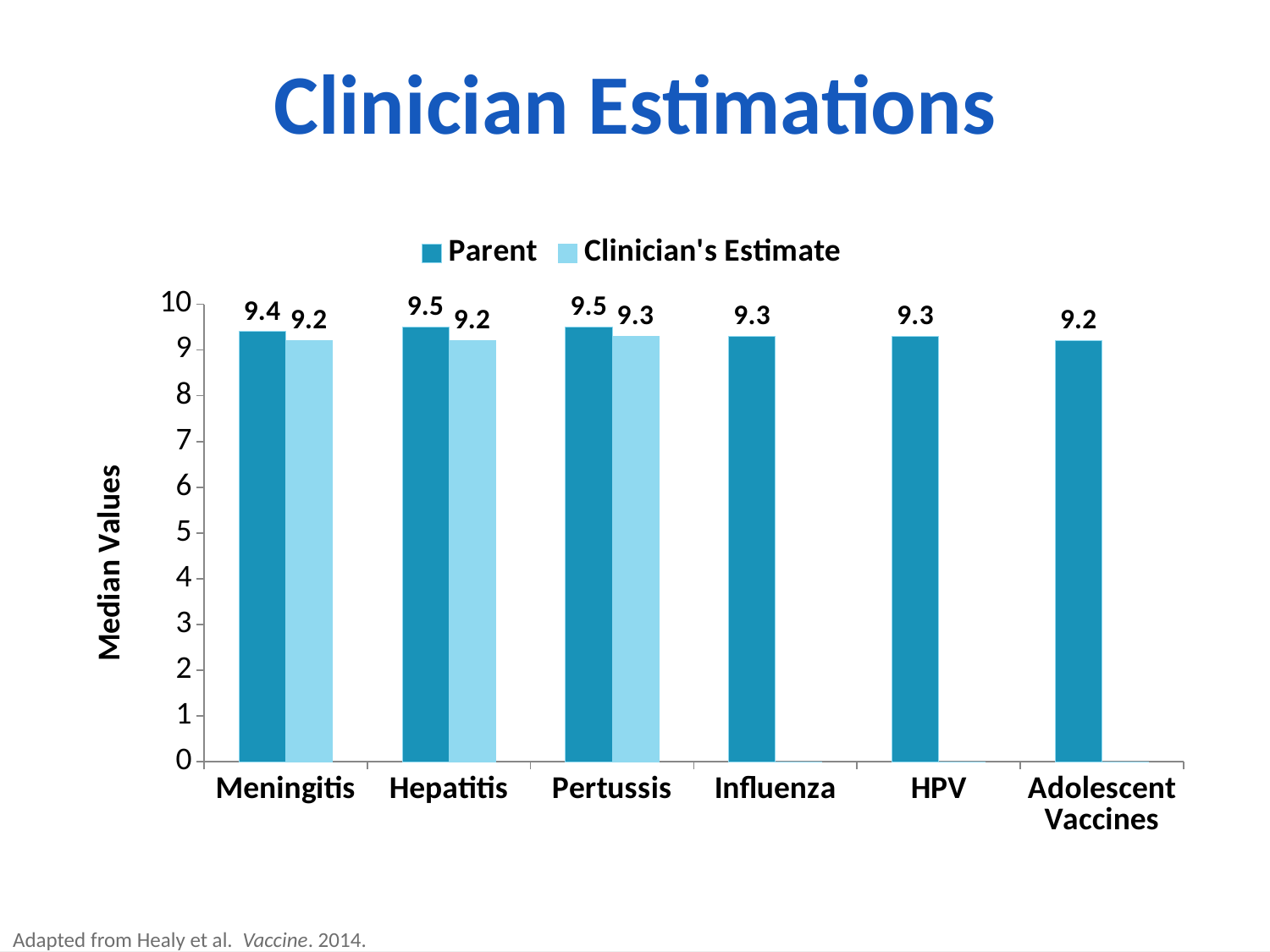
How many categories are shown on the x axis? 6 What is the difference between the Parent value and the Clinician's Estimate value for Hepatitis? 0.3 What is the title of the y axis? Median Values How many series does the legend list? 2 Which is larger for Pertussis, the Parent value or the Clinician's Estimate value? Parent What is the difference between the Parent value and the Clinician's Estimate value for Meningitis? 0.2 What is the Parent value for Adolescent Vaccines? 9.2 What is the Clinician's Estimate value for Pertussis? 9.3 What is the Clinician's Estimate value for Hepatitis? 9.2 What kind of chart is shown on the slide? Bar chart Which categories have a Clinician's Estimate bar shown? Meningitis, Hepatitis, Pertussis What is the Parent value for Meningitis? 9.4